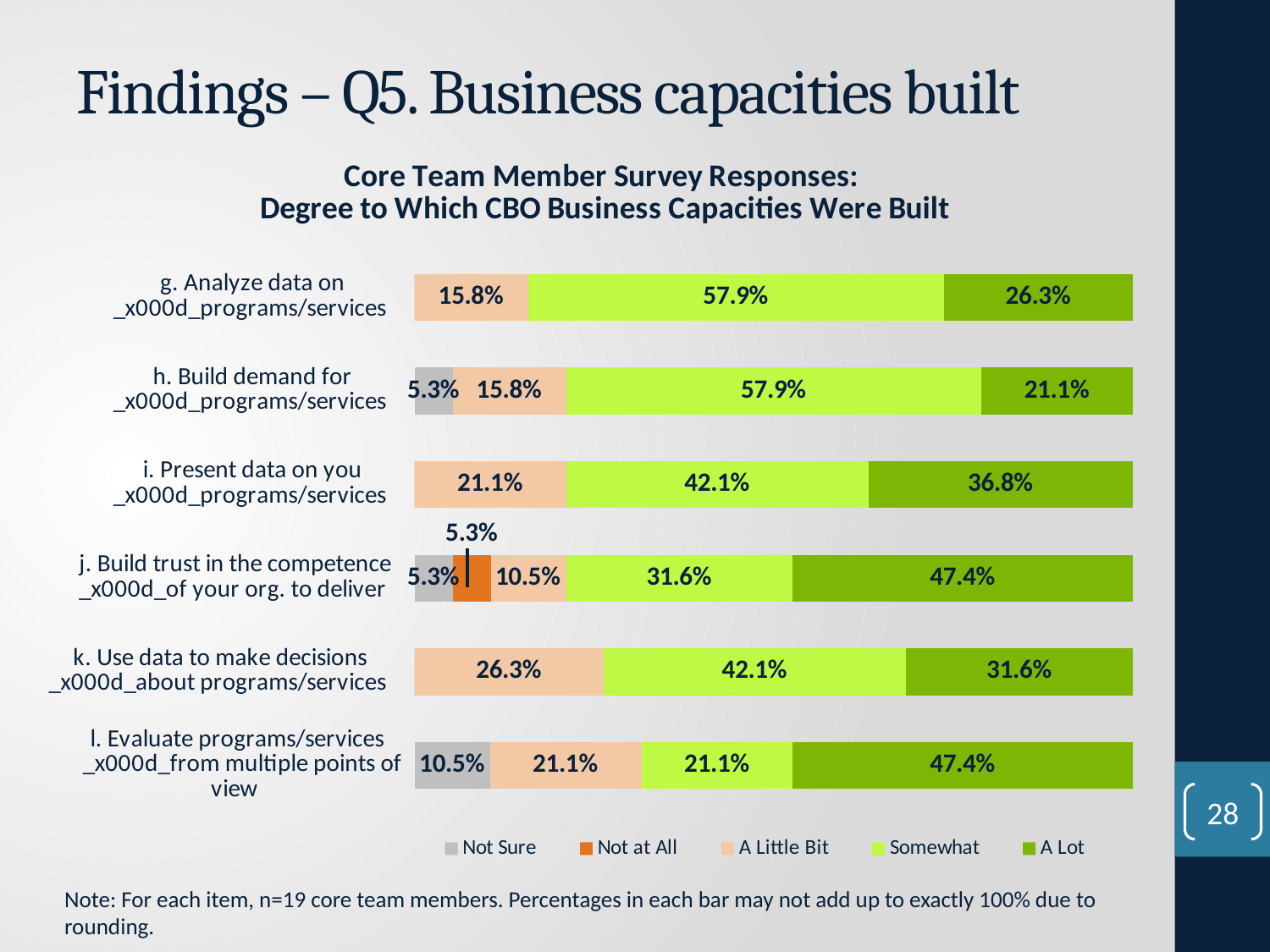
How many items (categories) are plotted in the chart? 6 What percentage of respondents answered "A Lot" for item i, Present data on your programs/services? 36.8% According to the note, how many core team members responded to each item? n=19 Which item has the highest "A Little Bit" percentage? k. Use data to make decisions about programs/services Which item has the lowest "A Lot" percentage? h. Build demand for programs/services What kind of chart is shown on the slide? Stacked bar chart What percentage of respondents answered "Not at All" for item j, Build trust in the competence of your org. to deliver? 5.3% What percentage of respondents answered "Not Sure" for item l, Evaluate programs/services from multiple points of view? 10.5% How many series does the legend list? 5 Which is larger: the "Somewhat" percentage for item i (Present data) or for item l (Evaluate programs/services)? i. Present data on your programs/services What is the difference between the "A Lot" percentages for item j (Build trust) and item k (Use data to make decisions)? 15.8% What percentage of respondents answered "Somewhat" for item g, Analyze data on programs/services? 57.9%